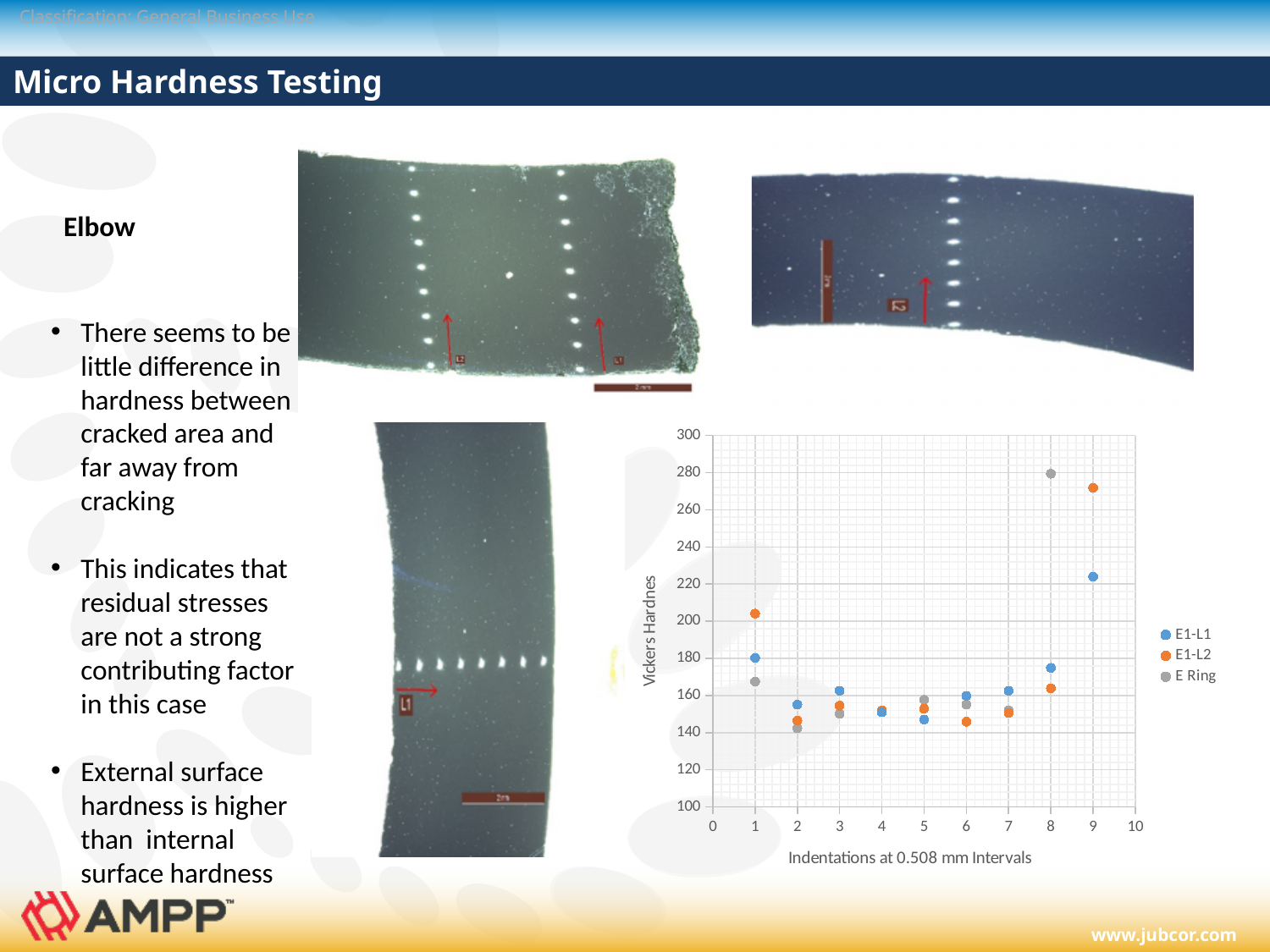
Is the E Ring value at indentation 8 greater or less than 260? greater How many series does the chart legend list? 3 What are the series names listed in the chart legend? E1-L1, E1-L2, E Ring What is the x-axis title of the chart? Indentations at 0.508 mm Intervals At indentation 9, which series has the larger value, E1-L1 or E1-L2? E1-L2 At which indentation does the E1-L1 series reach its highest value? 9 Is the E1-L2 value at indentation 9 greater or less than 260? greater Is the E1-L1 value at indentation 1 greater or less than 200? less Do the E1-L1 values rise or fall from indentation 5 to indentation 9? rise What kind of chart is shown on the slide? scatter chart At indentation 8, which series has the larger value, E Ring or E1-L1? E Ring